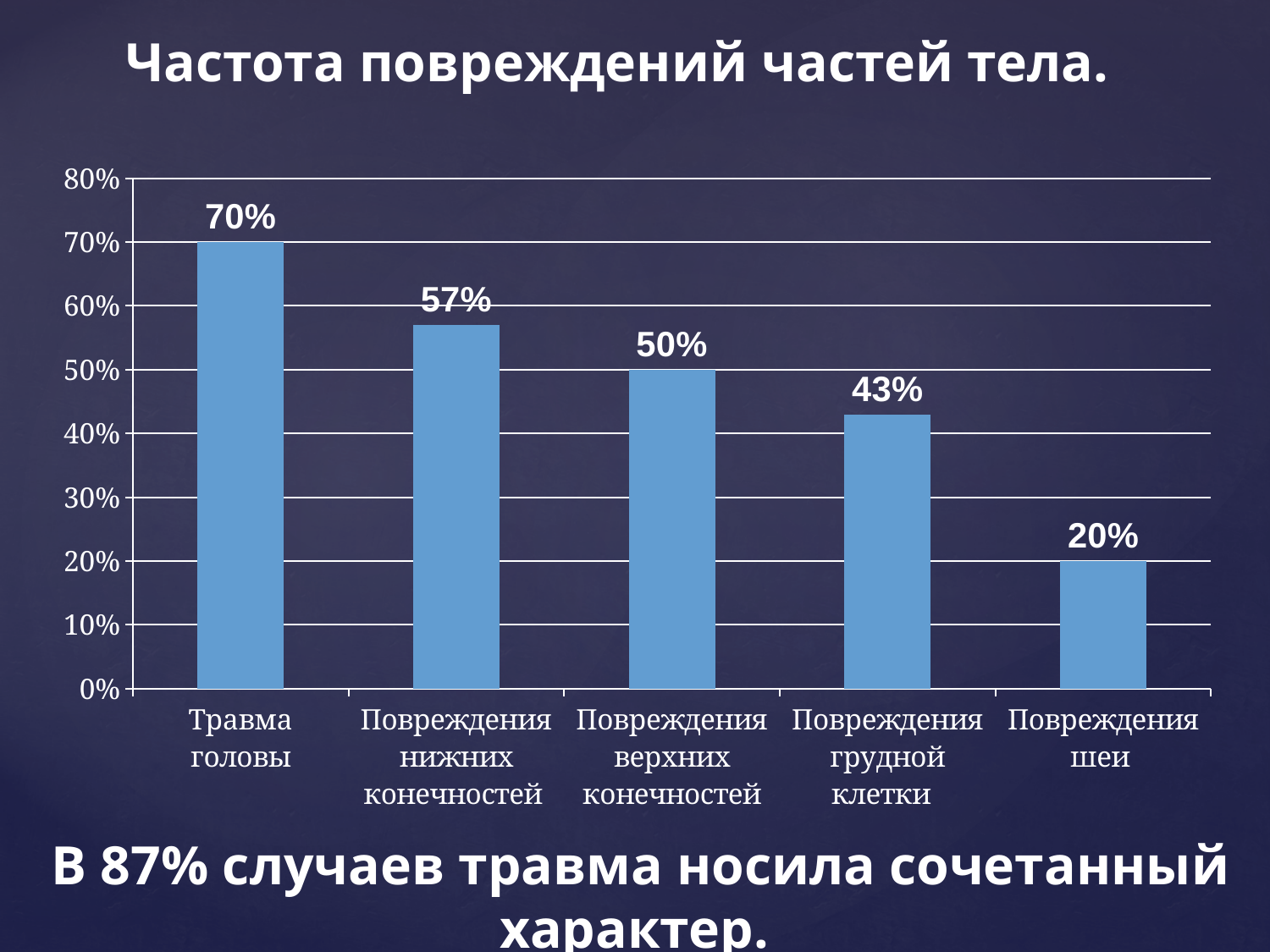
What is the difference between the values for Повреждения нижних конечностей and Повреждения верхних конечностей? 7% How many categories are shown in the chart? 5 What is the difference between the values for Травма головы and Повреждения шеи? 50% Do the values rise or fall from left to right along the x axis? fall Which is larger, the value for Повреждения верхних конечностей or Повреждения грудной клетки? Повреждения верхних конечностей What is the value for Повреждения шеи? 20% What is the value for Повреждения грудной клетки? 43% What is the value for Травма головы? 70% What kind of chart is shown on the slide? bar chart Which category has the lowest value? Повреждения шеи Is the value for Повреждения нижних конечностей greater or less than 50%? greater Which category has the highest value? Травма головы